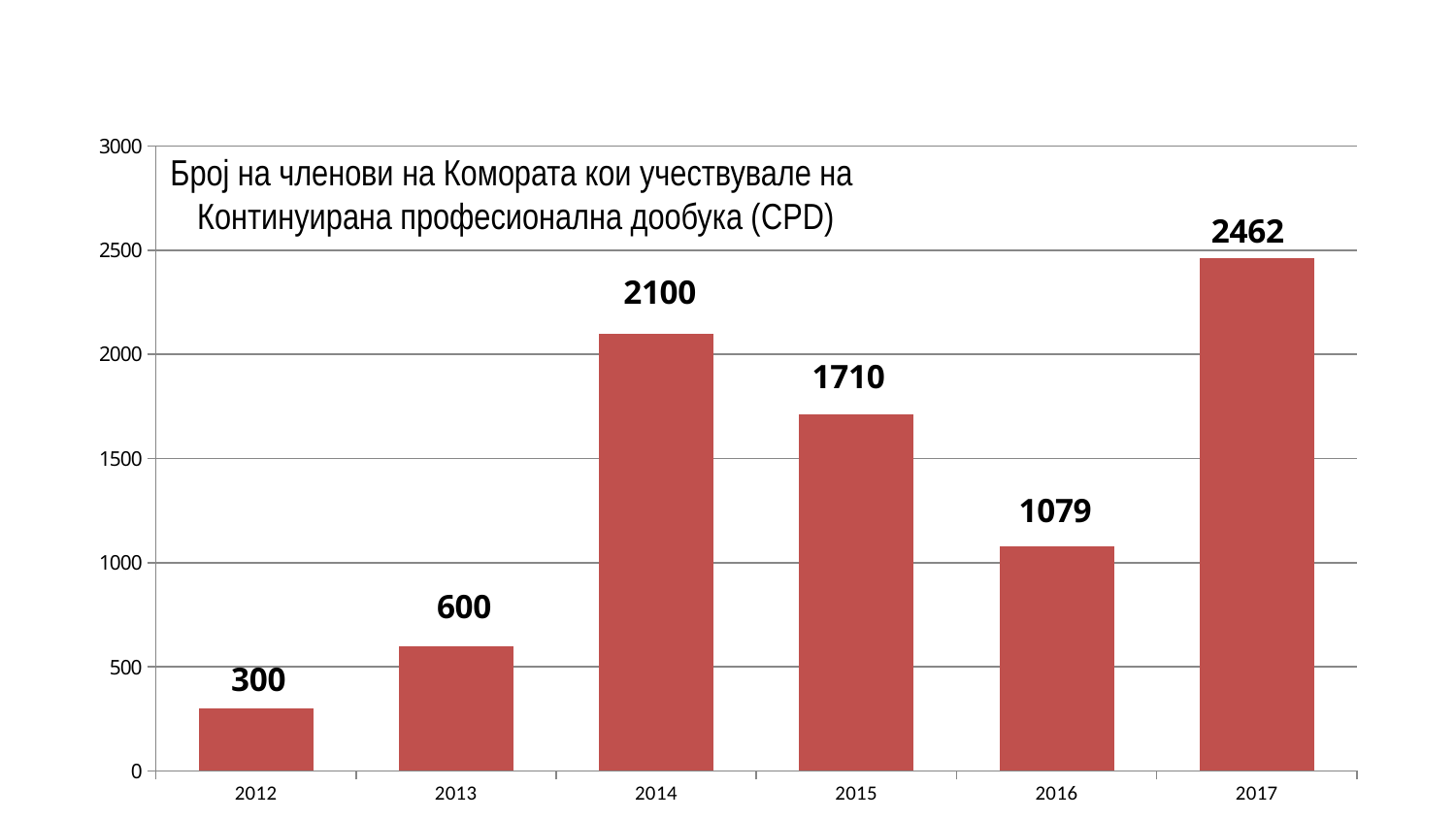
Which year has the lowest value? 2012 Is the value for 2015 greater or less than 1500? greater Which year has the highest value? 2017 What is the title of the chart? Број на членови на Комората кои учествувале на Континуирана професионална дообука (CPD) How many years are shown on the x axis? 6 What is the difference between the values for 2017 and 2016? 1383 What is the value for 2016? 1079 What is the difference between the values for 2013 and 2012? 300 What is the value for 2012? 300 Which is larger, the value for 2015 or the value for 2016? 2015 What is the value for 2014? 2100 What kind of chart is shown on the slide? bar chart